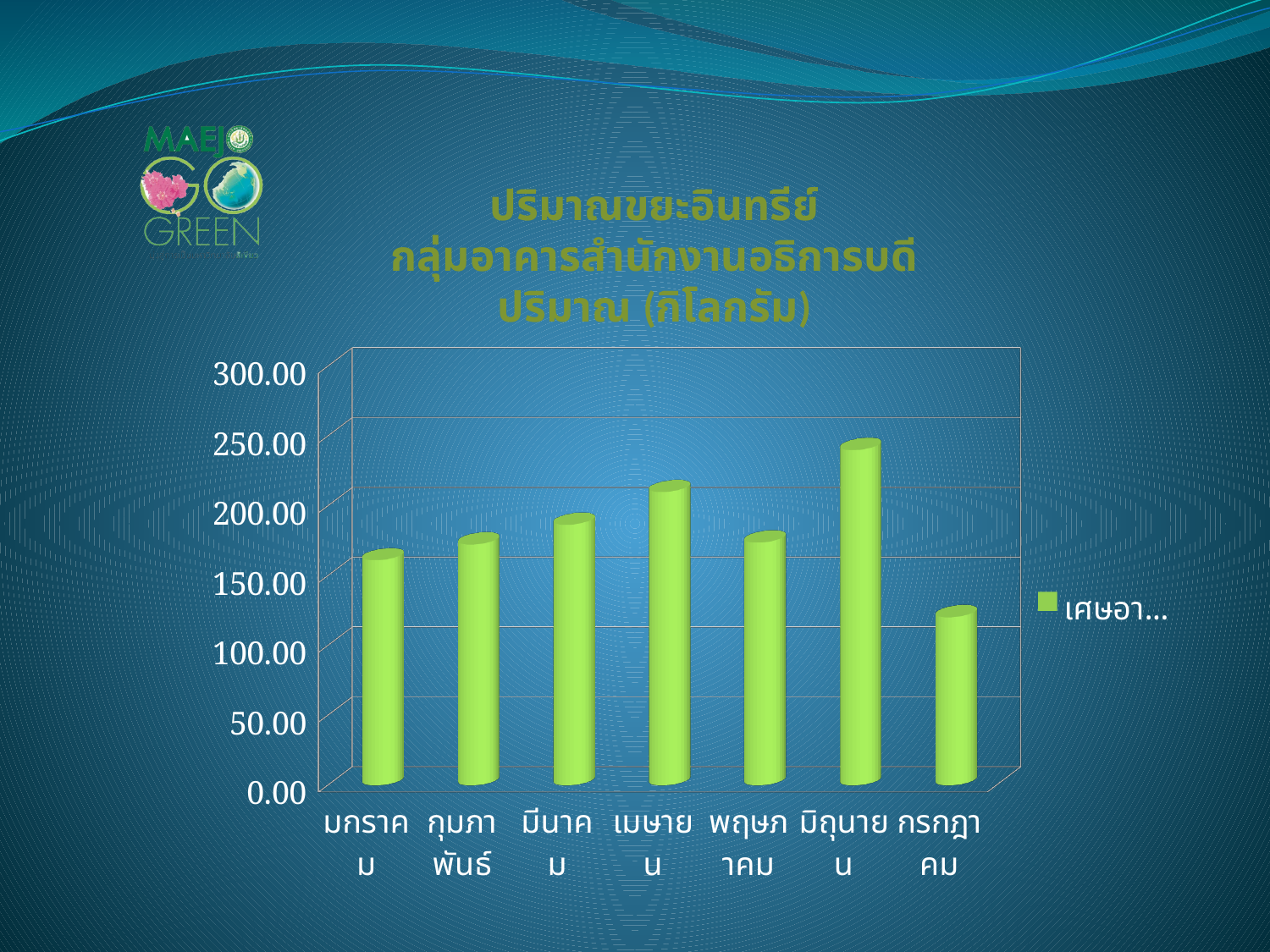
Is the value for กรกฎาคม greater or less than 150.00? less Which month has the lowest bar? กรกฎาคม How many months (categories) are plotted on the x axis? 7 Which month has the highest bar? มิถุนายน Which is larger, the value for มิถุนายน or the value for กรกฎาคม? มิถุนายน Which is larger, the value for เมษายน or the value for มกราคม? เมษายน Is the value for มกราคม greater or less than 200.00? less How many series does the legend list? 1 What unit is given in the chart title for the quantity plotted? กิโลกรัม Is the value for มิถุนายน greater or less than 200.00? greater What kind of chart is shown on the slide? Bar chart